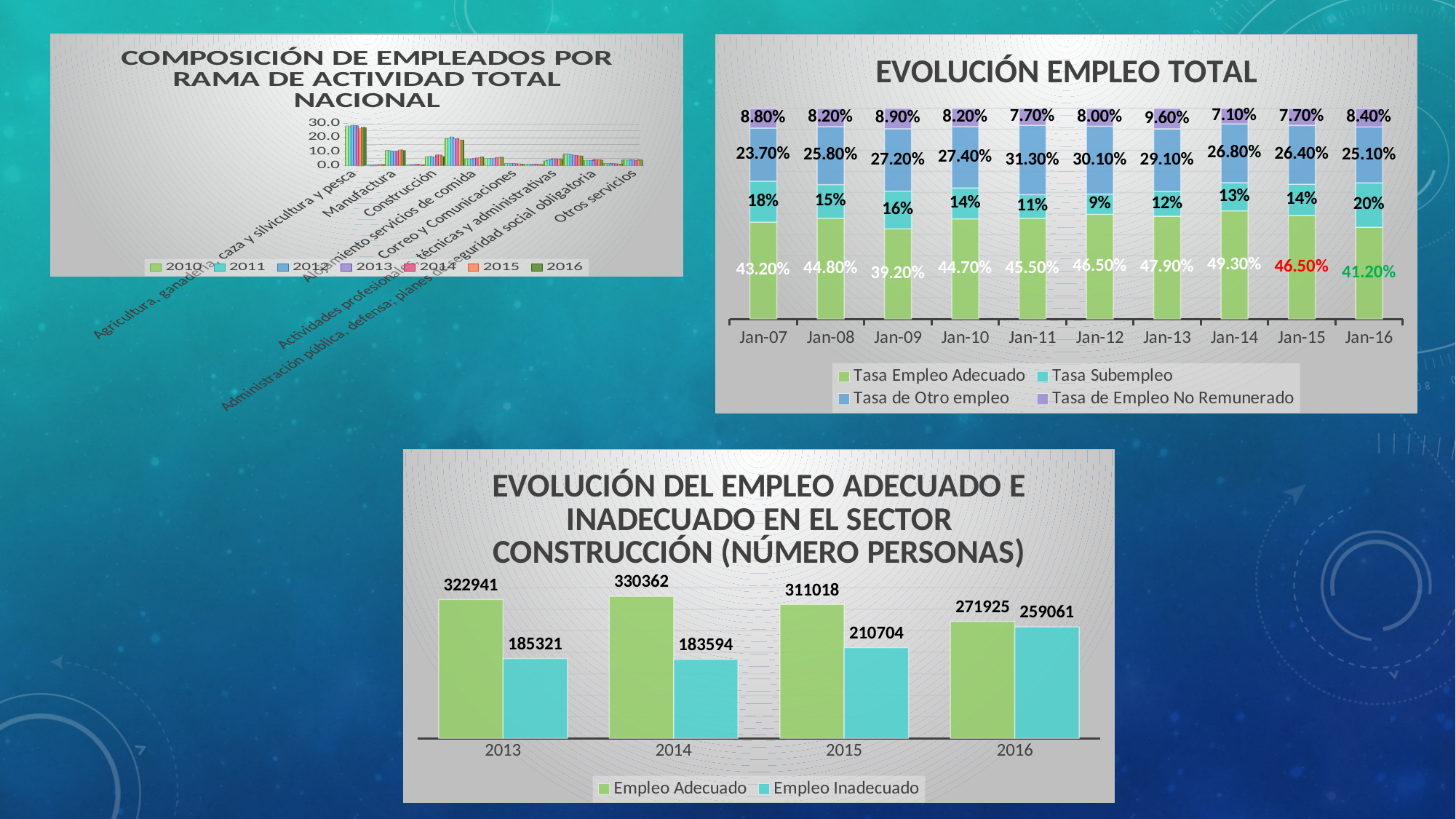
In the chart titled 'EVOLUCIÓN DEL EMPLEO ADECUADO E INADECUADO EN EL SECTOR CONSTRUCCIÓN', what is the value of Empleo Inadecuado in 2016? 259061 In the chart titled 'EVOLUCIÓN EMPLEO TOTAL', how many series does the legend list? 4 In the chart titled 'COMPOSICIÓN DE EMPLEADOS POR RAMA DE ACTIVIDAD TOTAL NACIONAL', how many series does the legend list? 7 In the chart titled 'EVOLUCIÓN DEL EMPLEO ADECUADO E INADECUADO EN EL SECTOR CONSTRUCCIÓN', what is the value of Empleo Adecuado in 2014? 330362 In the chart titled 'EVOLUCIÓN DEL EMPLEO ADECUADO E INADECUADO EN EL SECTOR CONSTRUCCIÓN', which year has the highest Empleo Adecuado value? 2014 In the chart titled 'EVOLUCIÓN EMPLEO TOTAL', what is the Tasa Empleo Adecuado for Jan-14? 49.30% In the chart titled 'EVOLUCIÓN EMPLEO TOTAL', which period has the highest Tasa de Otro empleo? Jan-11 In the chart titled 'EVOLUCIÓN DEL EMPLEO ADECUADO E INADECUADO EN EL SECTOR CONSTRUCCIÓN', what is the difference between Empleo Adecuado and Empleo Inadecuado in 2013? 137620 In the chart titled 'EVOLUCIÓN DEL EMPLEO ADECUADO E INADECUADO EN EL SECTOR CONSTRUCCIÓN', which year has the lowest Empleo Inadecuado value? 2014 In the chart titled 'EVOLUCIÓN EMPLEO TOTAL', what is the Tasa Subempleo for Jan-16? 20% In the chart titled 'EVOLUCIÓN DEL EMPLEO ADECUADO E INADECUADO EN EL SECTOR CONSTRUCCIÓN', how many years are shown on the x axis? 4